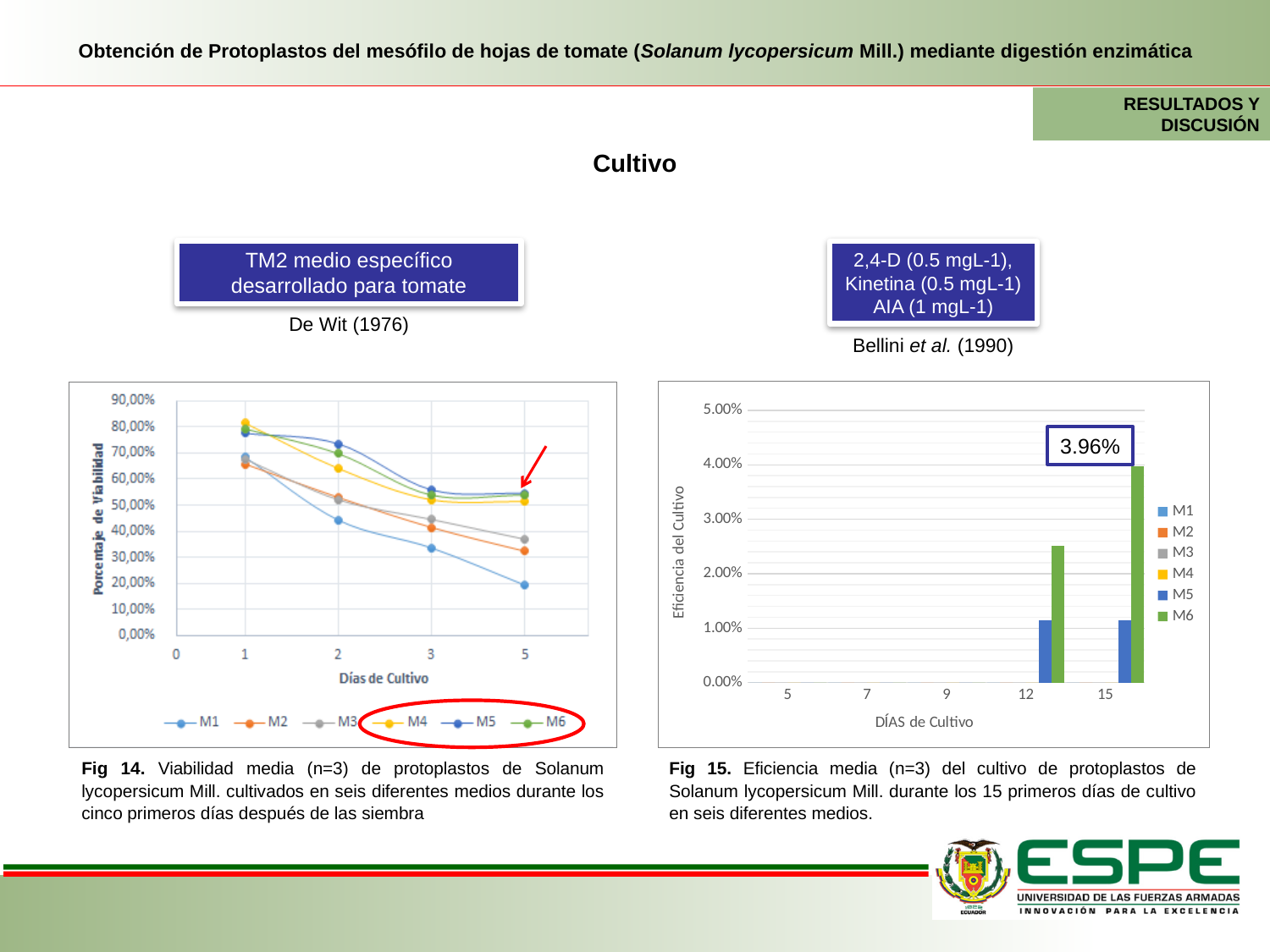
In the right chart (Fig 15), how many day categories are shown on the x axis? 5 In the left chart (Fig 14), how many series does the legend list? 6 In the right chart (Fig 15), which series has the larger value at day 15, M5 or M6? M6 What kind of chart is the left chart (Fig 14)? line chart In the left chart (Fig 14), which series has the higher viability at day 1, M4 or M1? M4 In the right chart (Fig 15), what value is printed on the label above the tallest bar? 3.96% In the left chart (Fig 14), which series has the lowest viability at day 5? M1 In the right chart (Fig 15), how many series does the legend list? 6 In the left chart (Fig 14), do the viability values generally rise or fall as the days of culture increase? fall In the left chart (Fig 14), is the value for M1 at day 5 greater or less than 30,00%? less In the right chart (Fig 15), is the value for M6 at day 12 greater or less than 2.00%? greater What kind of chart is the right chart (Fig 15)? bar chart